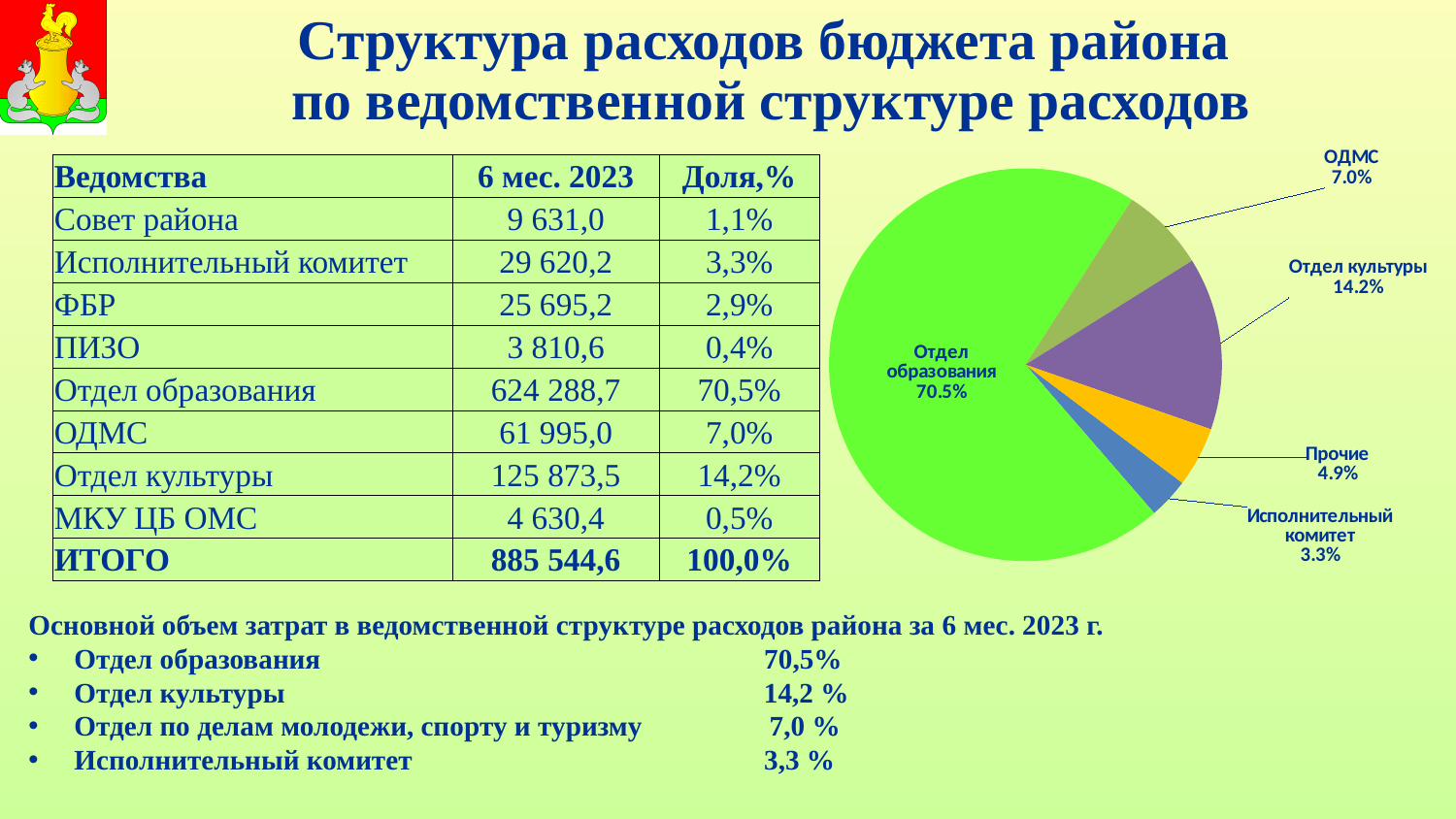
In the pie chart, what share is labelled for Исполнительный комитет? 3.3% In the pie chart, what is the difference in percentage points between Отдел культуры and ОДМС? 7.2 In the pie chart, which is larger: ОДМС or Отдел культуры? Отдел культуры Which slice of the pie chart is the smallest? Исполнительный комитет How many slices does the pie chart have? 5 What kind of chart is shown on the slide? pie chart In the pie chart, what share is labelled for Прочие? 4.9% In the pie chart, what share is labelled for ОДМС? 7.0% In the pie chart, what share is labelled for Отдел культуры? 14.2% Which slice of the pie chart is the largest? Отдел образования In the pie chart, what share is labelled for Отдел образования? 70.5% What colour is the Отдел образования slice in the pie chart? green